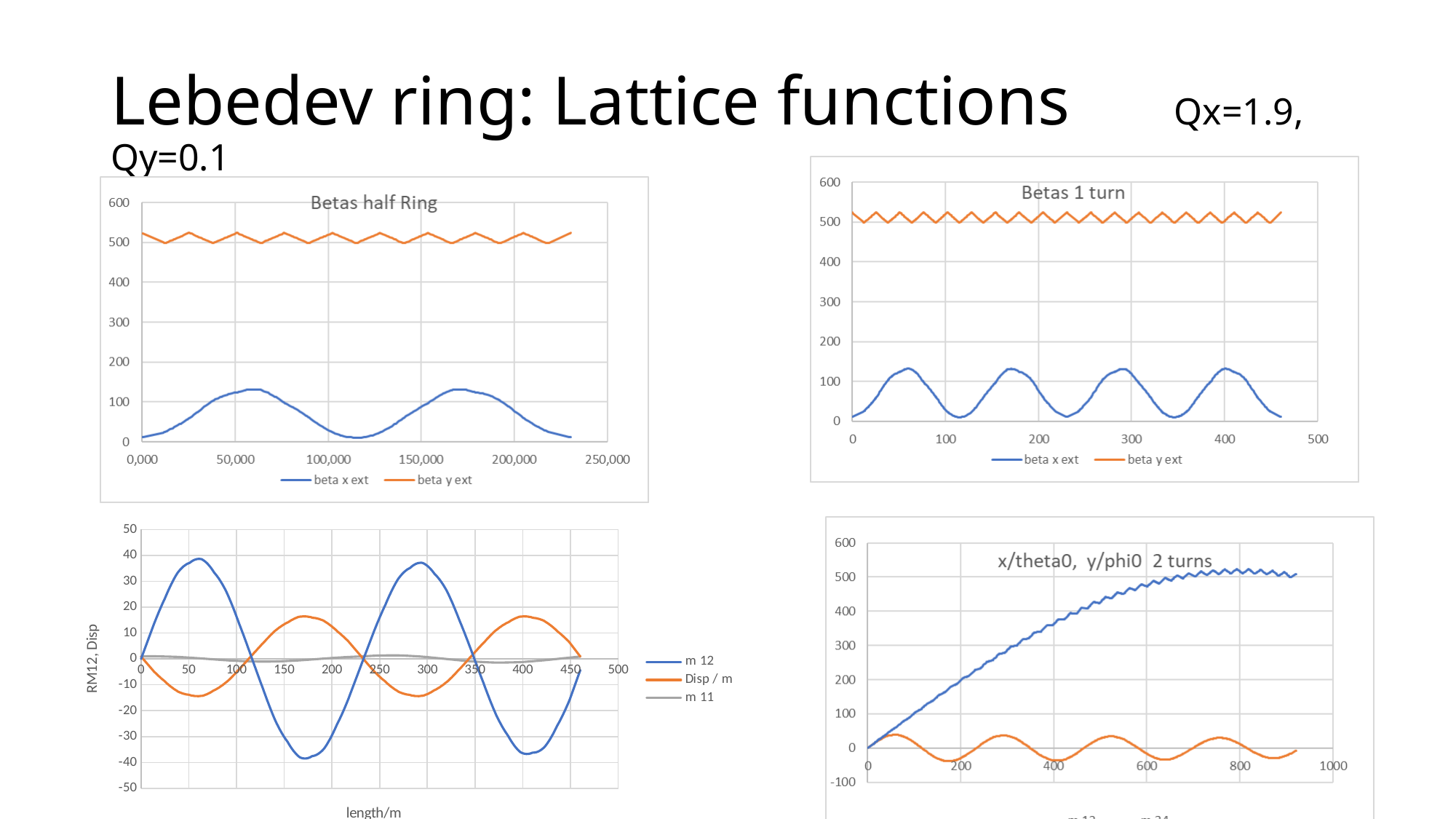
In the 'Betas half Ring' chart, how many series does the legend list? 2 In the bottom-left chart (y axis 'RM12, Disp'), how many series does the legend list? 3 In the 'x/theta0, y/phi0 2 turns' chart, does the blue series rise or fall overall along the x axis? rises What kind of chart is 'Betas 1 turn'? line chart In the 'x/theta0, y/phi0 2 turns' chart, is the blue series at x=800 greater or less than 400? greater In the 'Betas half Ring' chart, is the peak value of beta x ext greater or less than 200? less In the 'Betas 1 turn' chart, is the value of beta y ext greater or less than 400? greater What is the x-axis title of the bottom-left chart (y axis 'RM12, Disp')? length/m In the 'Betas 1 turn' chart, which series has the higher values, beta x ext or beta y ext? beta y ext In the 'Betas half Ring' chart, what colour is the beta y ext series? orange In the bottom-left chart (y axis 'RM12, Disp'), which series reaches the larger peak, m 12 or Disp / m? m 12